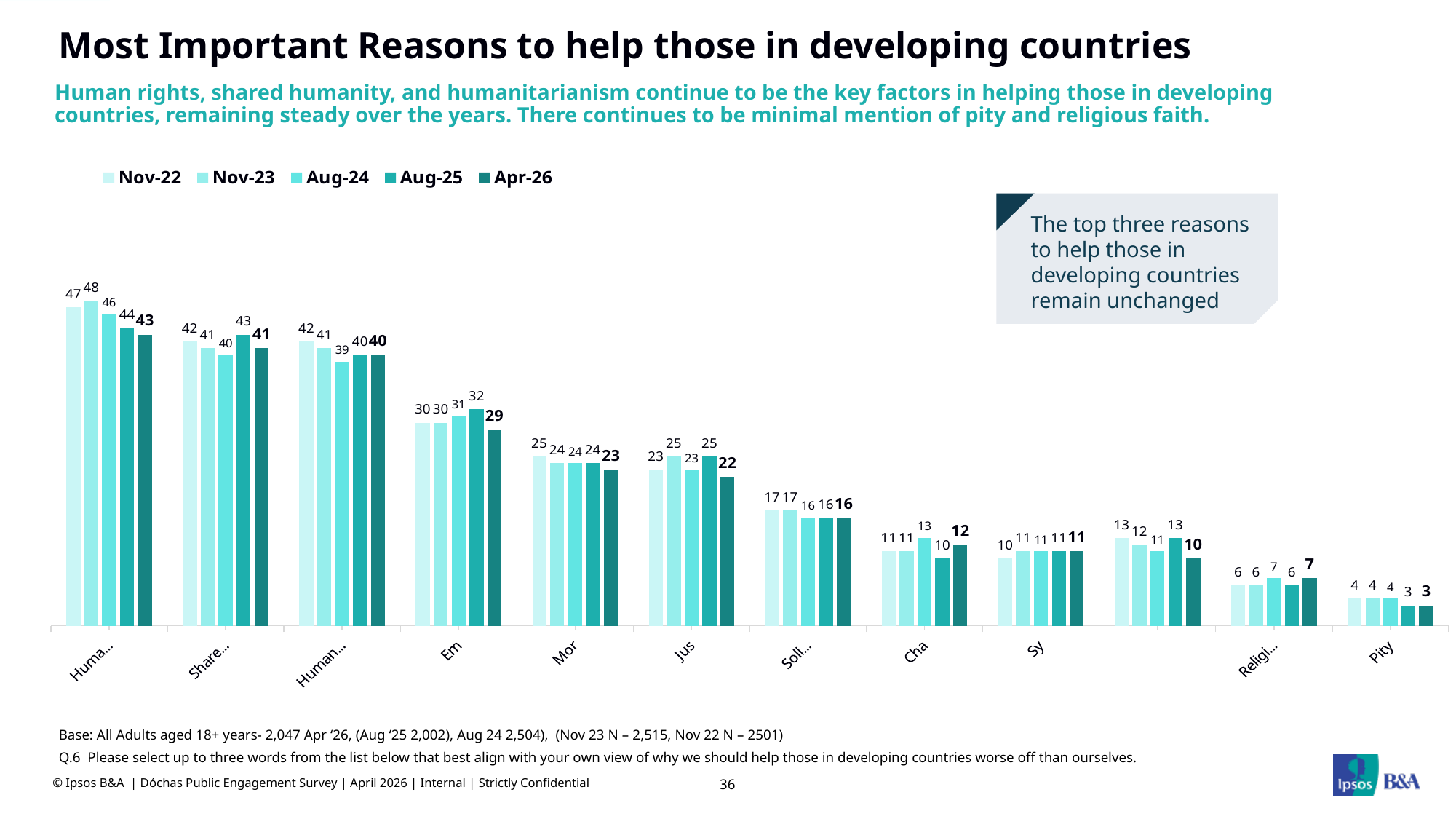
What kind of chart is shown on the slide? bar chart Do the values for Pity rise or fall from Nov-22 to Apr-26? fall Which category has the lowest Apr-26 value? Pity In the leftmost category group, which series has the highest value? Nov-23 What is the Apr-26 value for the leftmost category group? 43 What is the first entry in the chart legend? Nov-22 For Pity, which is larger: the Nov-22 value or the Apr-26 value? Nov-22 What is the Nov-22 value for Pity? 4 What is the difference between the Nov-22 and Apr-26 values for Pity? 1 How many category groups are plotted along the x axis? 12 How many series does the legend list? 5 What is the Apr-26 value for Pity? 3